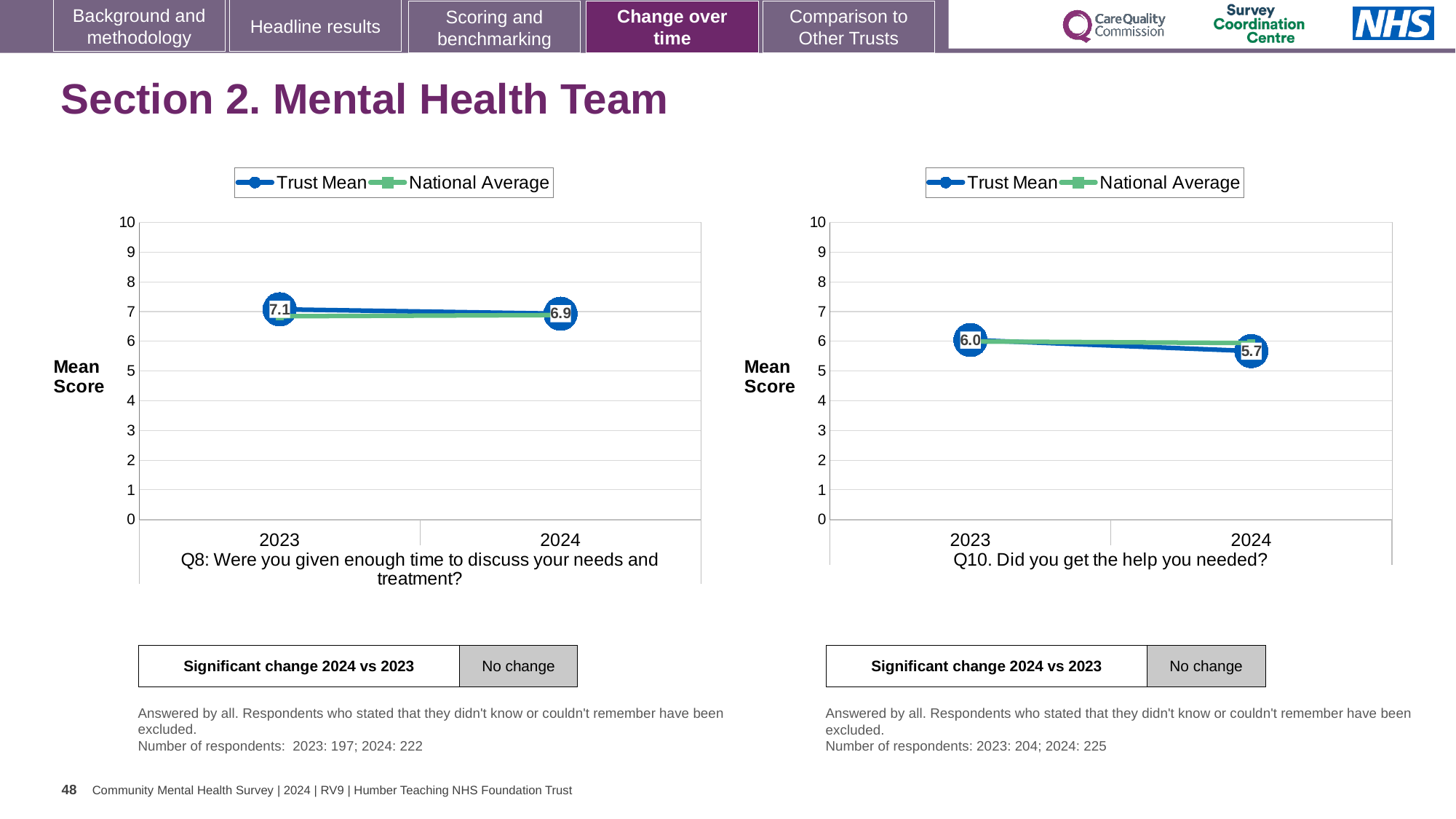
In the Q8 chart on the left, which year has the higher Trust Mean, 2023 or 2024? 2023 How many years are plotted on the x axis of the Q8 chart on the left? 2 In the Q10 chart on the right, does the Trust Mean rise or fall from 2023 to 2024? fall In the Q8 chart on the left, what is the Trust Mean for 2023? 7.1 In the Q10 chart on the right, what is the Trust Mean for 2024? 5.7 In the Q8 chart on the left, by how much did the Trust Mean change from 2023 to 2024? 0.2 In the Q10 chart on the right, what is the Trust Mean for 2023? 6.0 What type of chart is used for Q8 on the left? line chart In the Q8 chart on the left, what is the Trust Mean for 2024? 6.9 In the Q10 chart on the right, is the Trust Mean for 2024 greater or less than 6? less How many series does the legend of the Q10 chart on the right list? 2 In the Q10 chart on the right, what is the difference between the Trust Mean in 2023 and 2024? 0.3